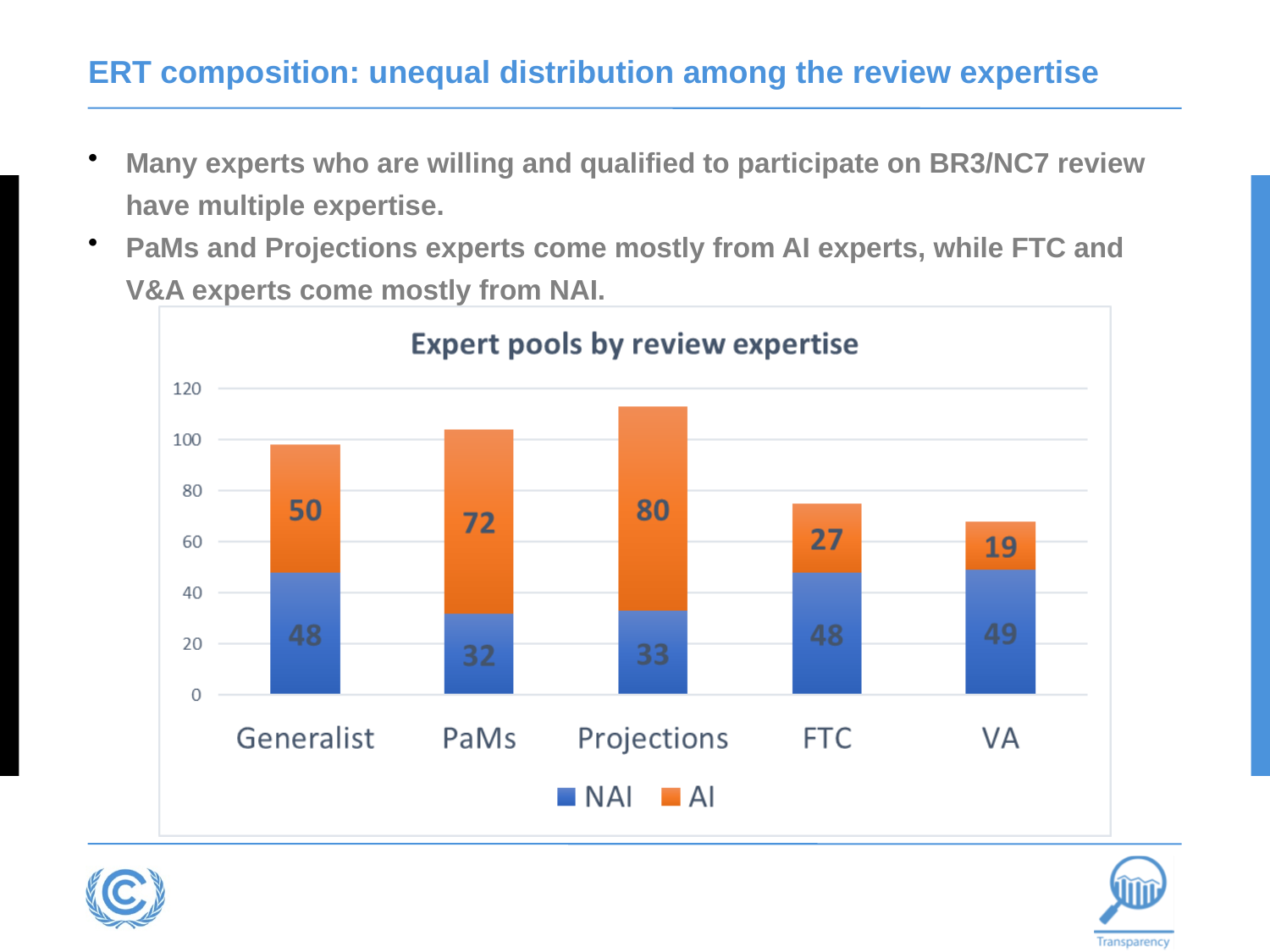
What is the total of the stacked bar for VA? 68 What is the AI value for Projections? 80 Which is larger, the NAI value for FTC or the NAI value for PaMs? FTC What is the AI value for VA? 19 How many series does the legend list? 2 What kind of chart is shown? Stacked bar chart Which category has the highest AI value? Projections How many categories are shown on the x axis? 5 What is the difference between the AI values for PaMs and FTC? 45 What is the NAI value for Generalist? 48 What is the total of the stacked bar for Projections? 113 Which category has the lowest NAI value? PaMs